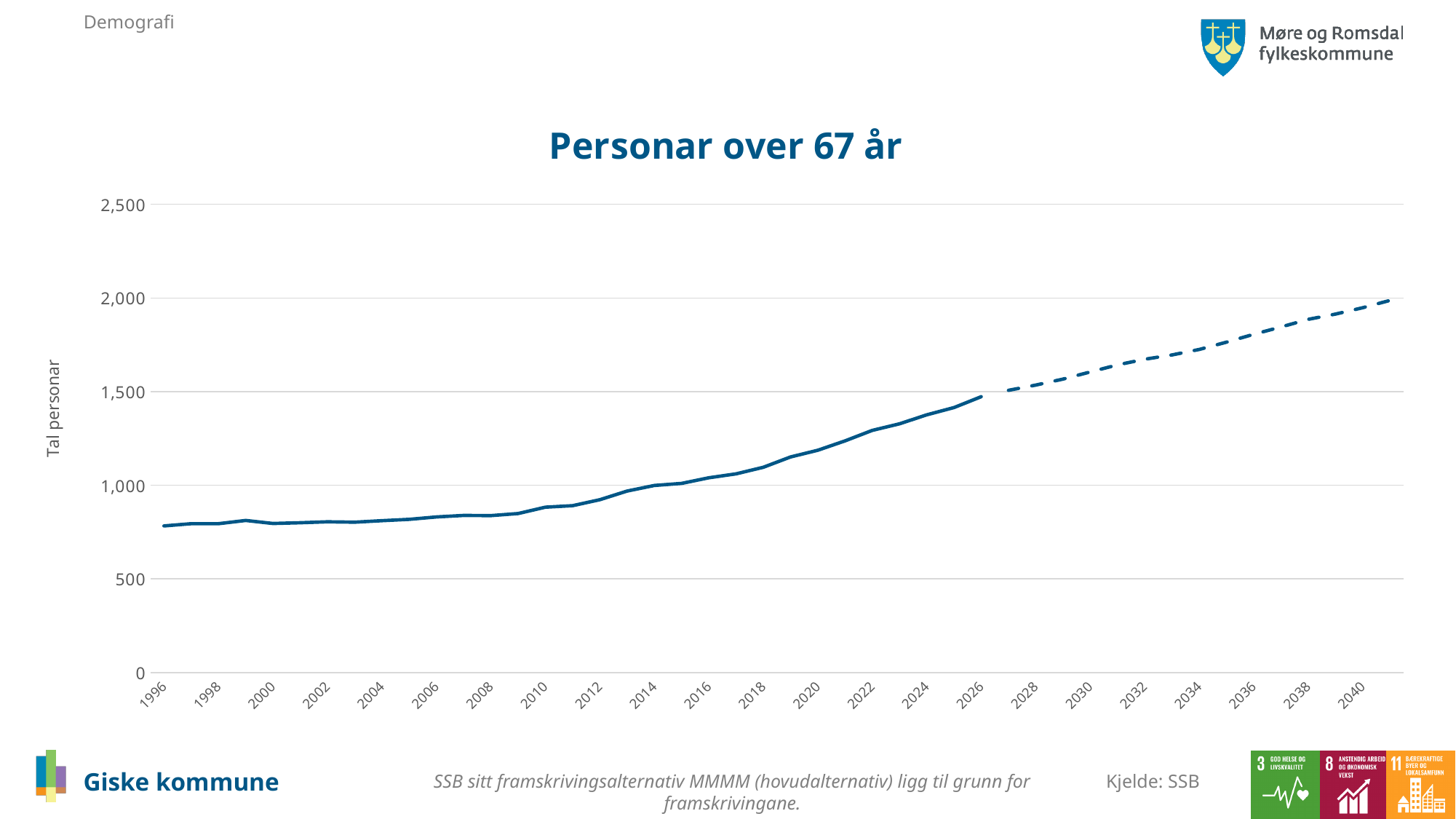
Is the value for 1996 greater or less than 1,000? less What kind of chart is shown on the slide? line chart Is the value for 2010 greater or less than 1,000? less Do the values rise or fall from 1996 to 2040? rise How many year labels are shown on the horizontal axis? 23 Is the value for 2038 greater or less than 2,000? less What is the label on the vertical axis? Tal personar What is the title of the chart? Personar over 67 år